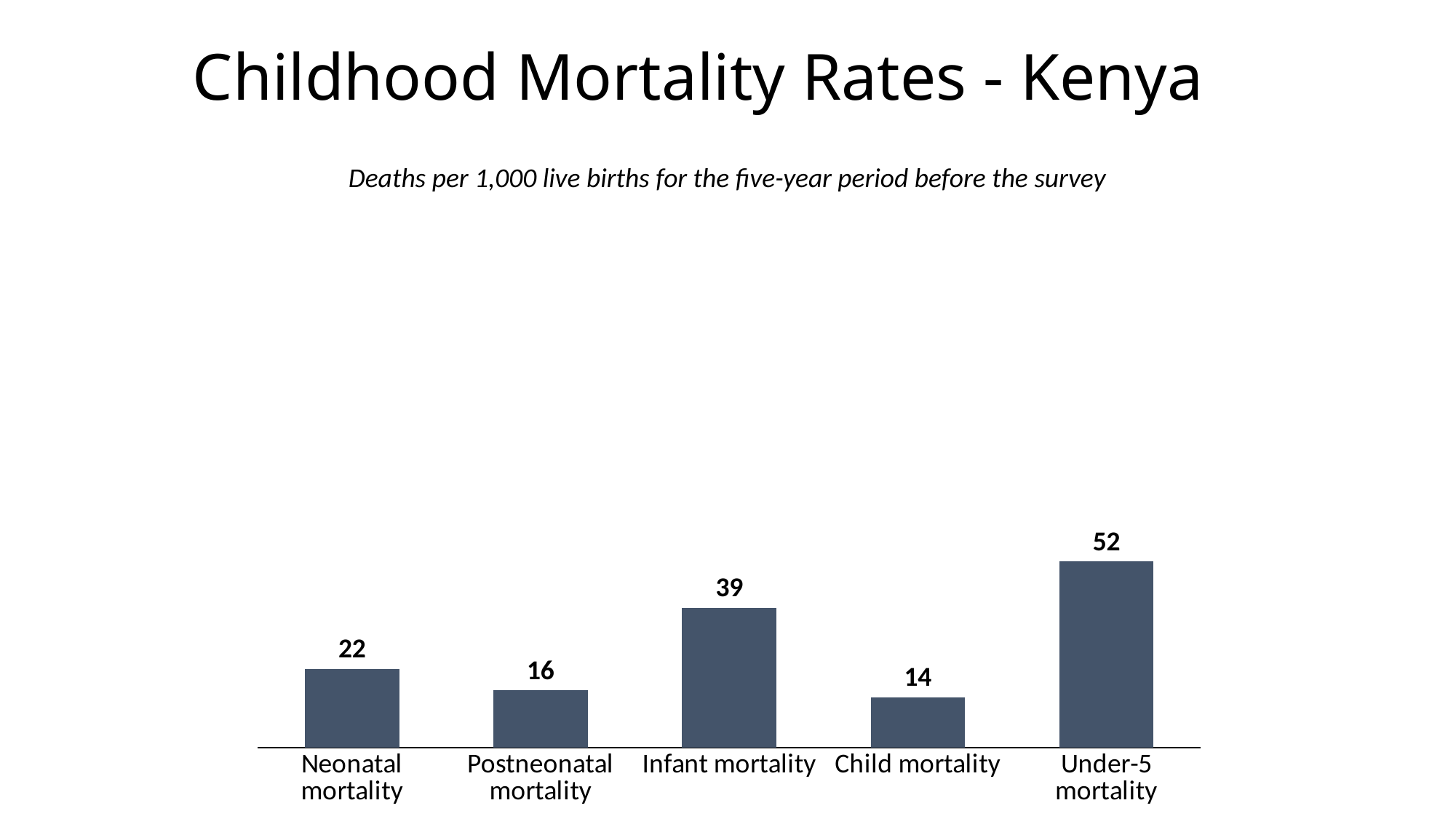
What is the value for Under-5 mortality? 52 What is the value for Infant mortality? 39 Which category has the highest value? Under-5 mortality How many categories are shown in the chart? 5 Which category has the lowest value? Child mortality Which is larger, Neonatal mortality or Postneonatal mortality? Neonatal mortality What is the title of the slide? Childhood Mortality Rates - Kenya What is the value for Postneonatal mortality? 16 What is the value for Child mortality? 14 What kind of chart is shown on the slide? Bar chart What is the difference between Under-5 mortality and Infant mortality? 13 What is the value for Neonatal mortality? 22